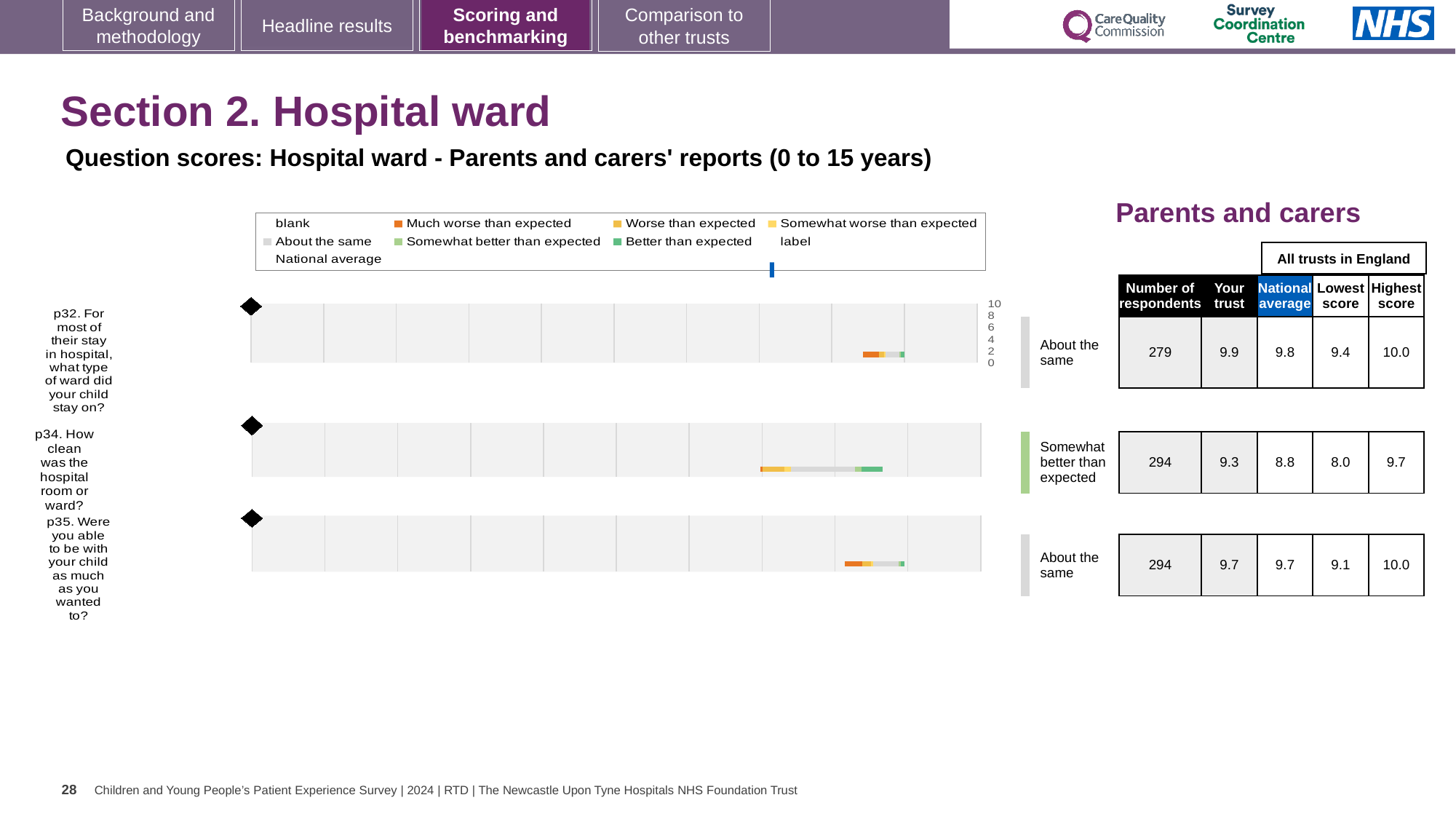
What is the 'Your trust' score for p32 (what type of ward did your child stay on)? 9.9 Which question has the lowest 'Your trust' score? p34 What is the lowest score across all trusts in England for p32? 9.4 What is the highest score across all trusts in England for p34? 9.7 How many questions (p32, p34, p35) are plotted on the slide? 3 What kind of chart is used to show the question scores on this slide? bar chart What benchmark category is shown for p34 (how clean was the hospital room or ward)? Somewhat better than expected Which question has the highest 'Your trust' score? p32 For p34, what is the difference between the 'Your trust' score and the national average? 0.5 How many respondents answered p35 (were you able to be with your child as much as you wanted to)? 294 For p34, which is larger: the 'Your trust' score or the national average? Your trust What is the national average score for p34 (how clean was the hospital room or ward)? 8.8